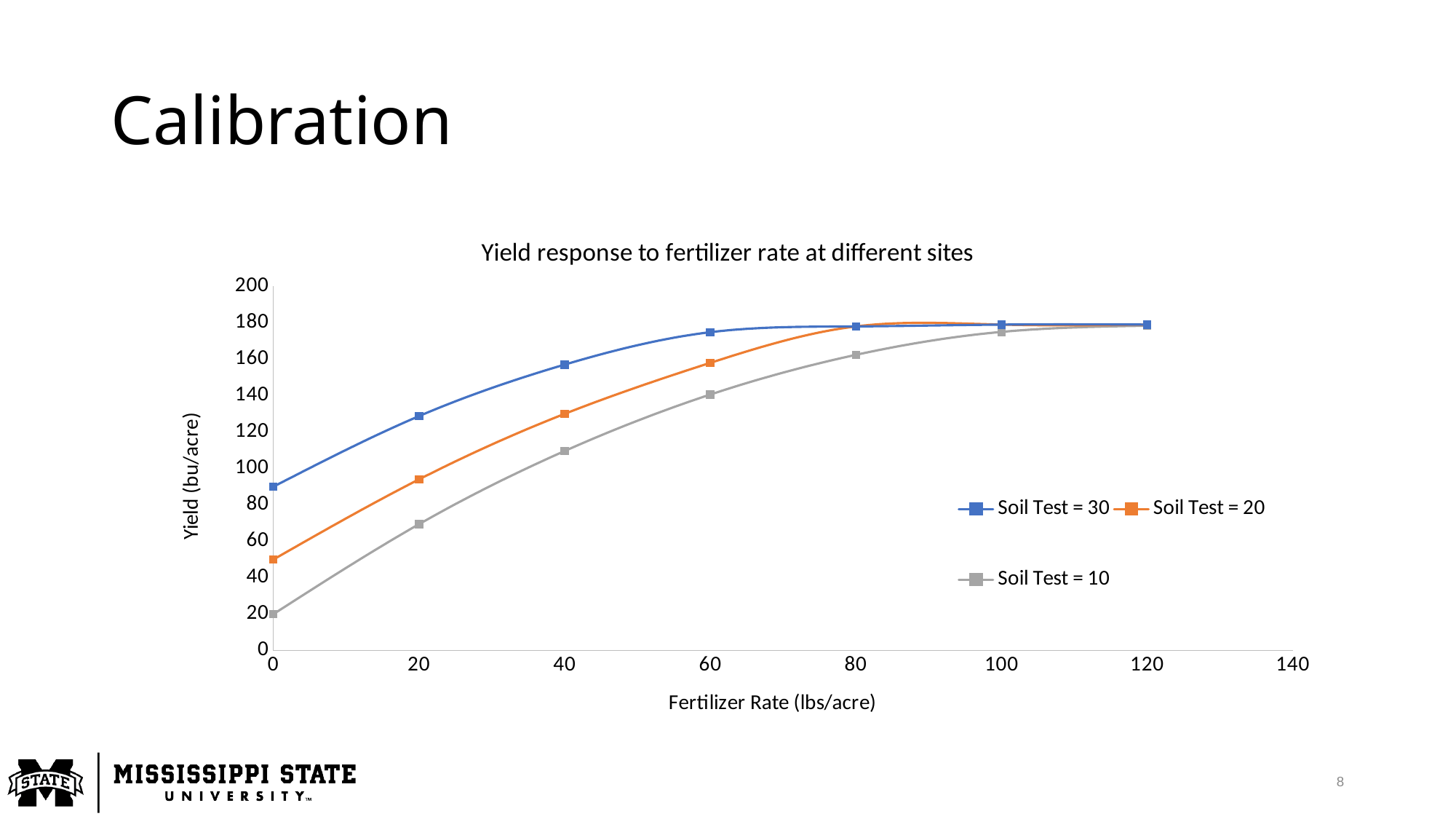
Which series has the lowest yield at a fertilizer rate of 0? Soil Test = 10 Does the yield for Soil Test = 10 rise or fall as the fertilizer rate increases? rise Is the yield for Soil Test = 20 at a fertilizer rate of 40 greater or less than 120? greater Is the yield for Soil Test = 30 at a fertilizer rate of 0 greater or less than 80? greater What is the label of the y axis? Yield (bu/acre) How many data points are plotted for the Soil Test = 10 series? 7 What kind of chart is shown on the slide? line chart At a fertilizer rate of 40, which is larger: the yield for Soil Test = 30 or for Soil Test = 10? Soil Test = 30 How many series does the legend list? 3 What is the title of the chart? Yield response to fertilizer rate at different sites Which series has the highest yield at a fertilizer rate of 20? Soil Test = 30 Is the yield for Soil Test = 10 at a fertilizer rate of 20 greater or less than 60? greater